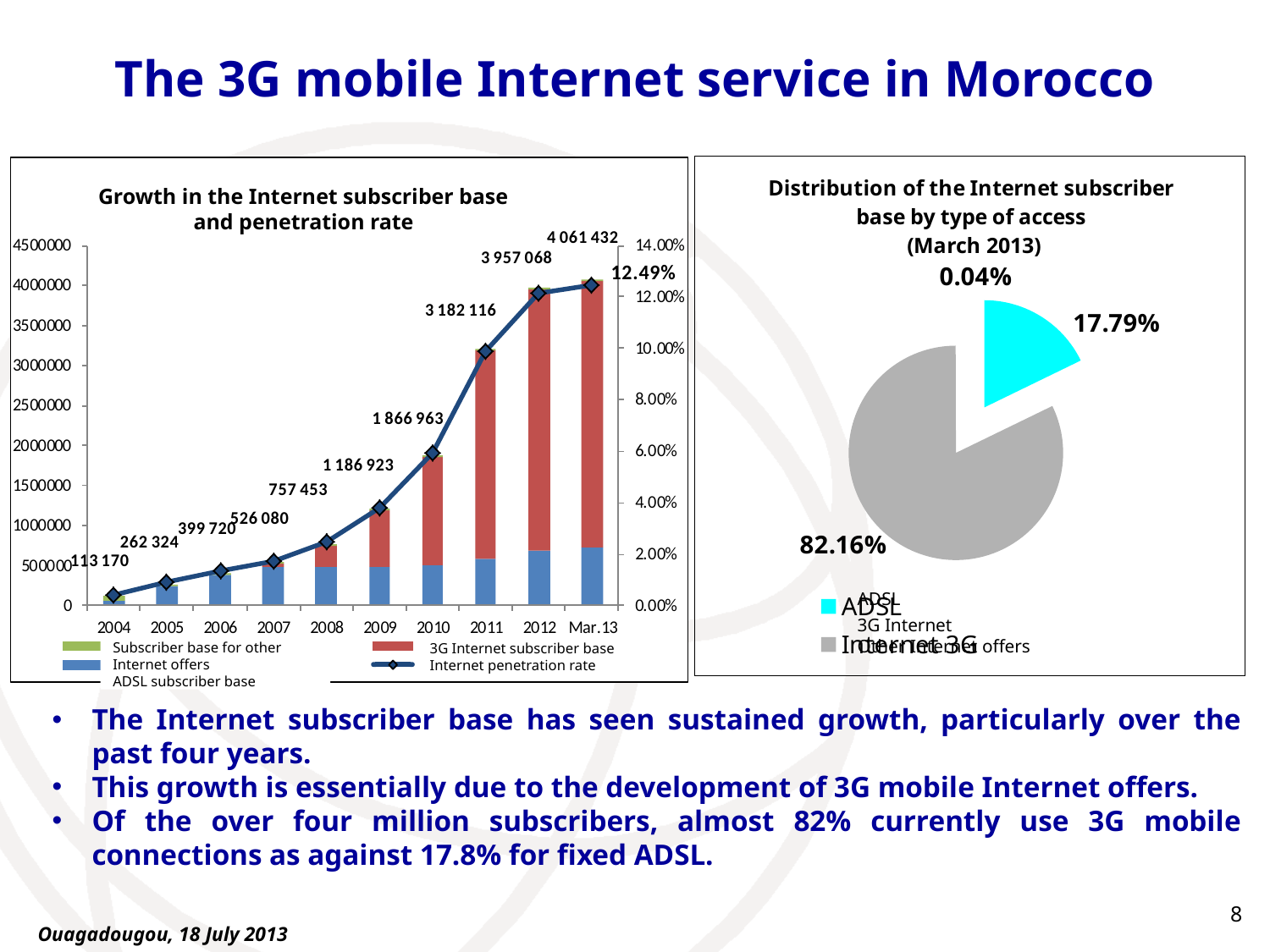
In the left chart, is the Internet penetration rate for 2011 greater or less than 8.00%? greater In the left chart, what Internet penetration rate is labelled for Mar.13? 12.49% How many time periods are shown on the x axis of the left chart? 10 In the left chart, what is the difference between the total subscriber base in 2012 and in 2011? 774 952 In the left chart, which year has the lowest total Internet subscriber base? 2004 In the left chart, what is the total Internet subscriber base labelled for Mar.13? 4 061 432 How many entries does the legend of the left chart list? 4 Does the total Internet subscriber base in the left chart rise or fall from 2004 to Mar.13? rise What kind of chart is the 'Distribution of the Internet subscriber base by type of access' chart? pie chart In the pie chart, what share of the Internet subscriber base does the largest slice represent? 82.16% In the left chart, which is larger, the total subscriber base in 2008 or in 2009? 2009 In the left chart, what is the total Internet subscriber base labelled for 2010? 1 866 963